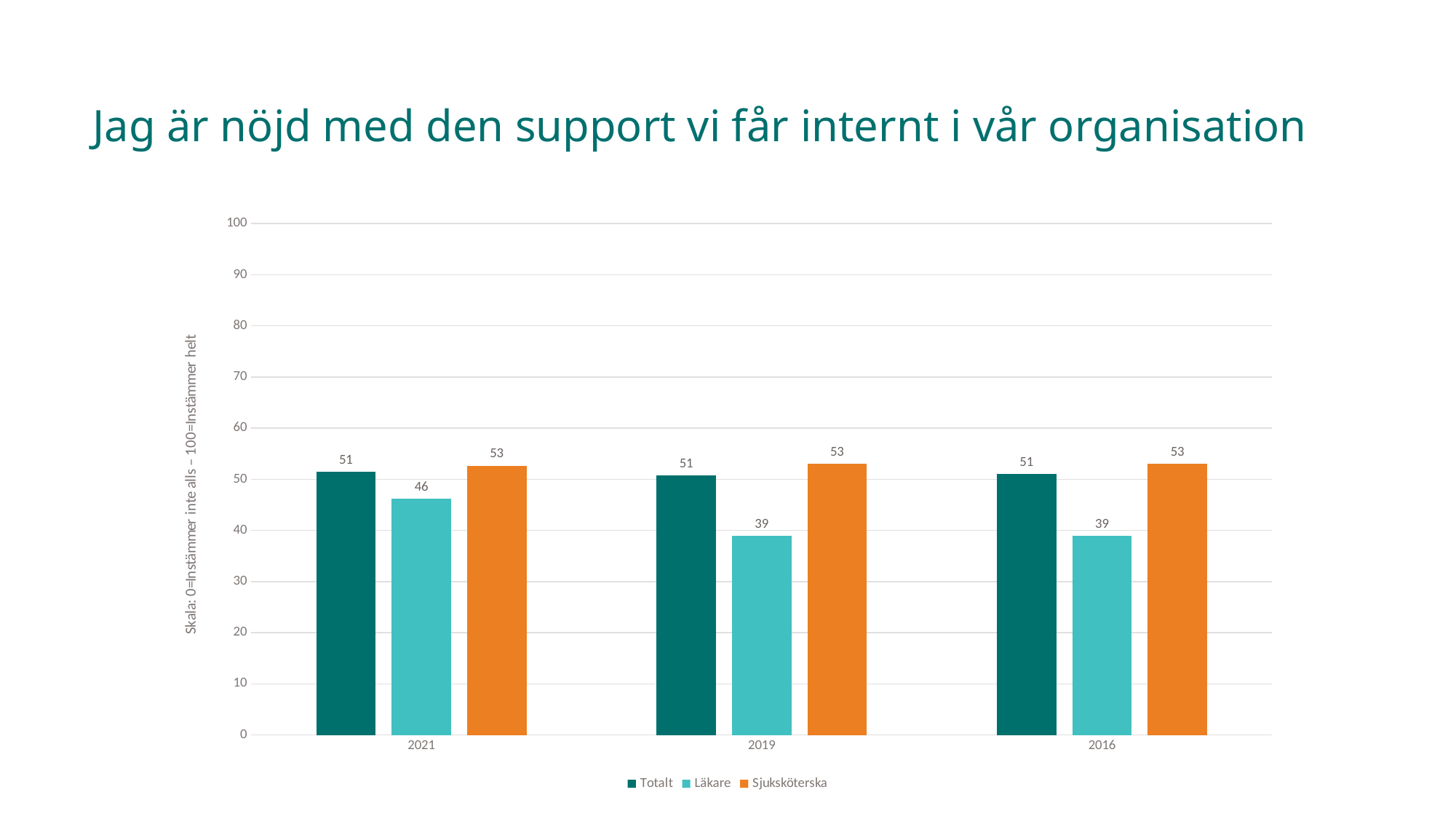
What is the value for Sjuksköterska in 2019? 53 Which series has the highest value in 2021? Sjuksköterska Which series has the lowest value in 2019? Läkare What is the value for Läkare in 2016? 39 How many year categories are shown on the x axis? 3 What is the difference between the Läkare values in 2021 and 2016? 7 How many series does the legend list? 3 What is the value for Totalt in 2016? 51 What kind of chart is shown on the slide? Bar chart What is the difference between the Sjuksköterska and Läkare values in 2019? 14 What is the value for Läkare in 2021? 46 Which is larger in 2021, the value for Totalt or the value for Läkare? Totalt